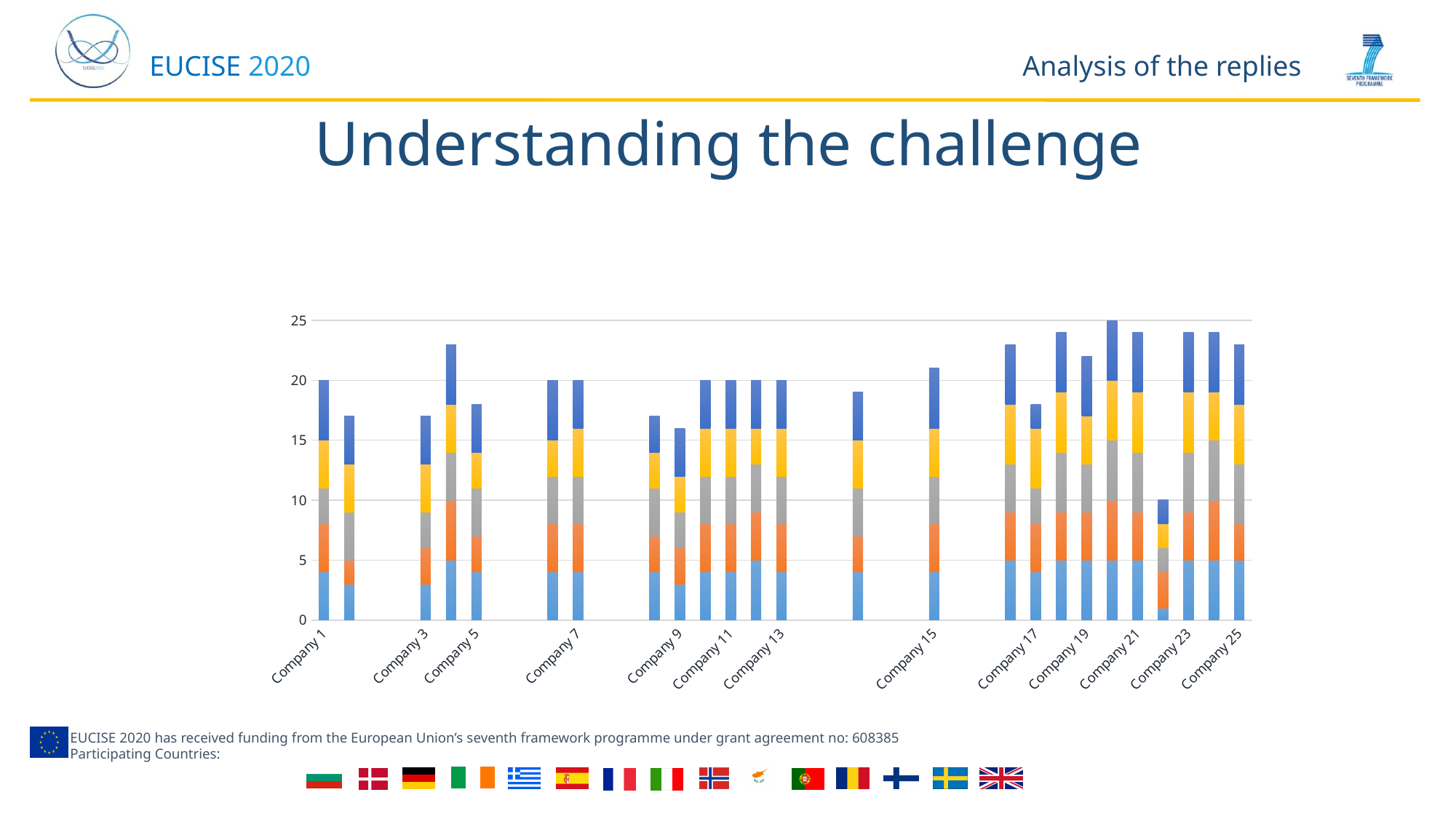
What is the total height of the stacked bar for Company 1? 20 Is the total for Company 3 greater or less than 15? greater Which has the taller stacked bar, Company 21 or Company 17? Company 21 What is the highest value shown on the vertical axis? 25 Which has the taller stacked bar, Company 1 or Company 3? Company 1 Is the total for Company 9 greater or less than 20? less What is the total height of the stacked bar for Company 7? 20 Is the total for Company 17 greater or less than 20? less How many stacked bars are plotted in the chart? 25 What kind of chart is shown on the slide? stacked bar chart